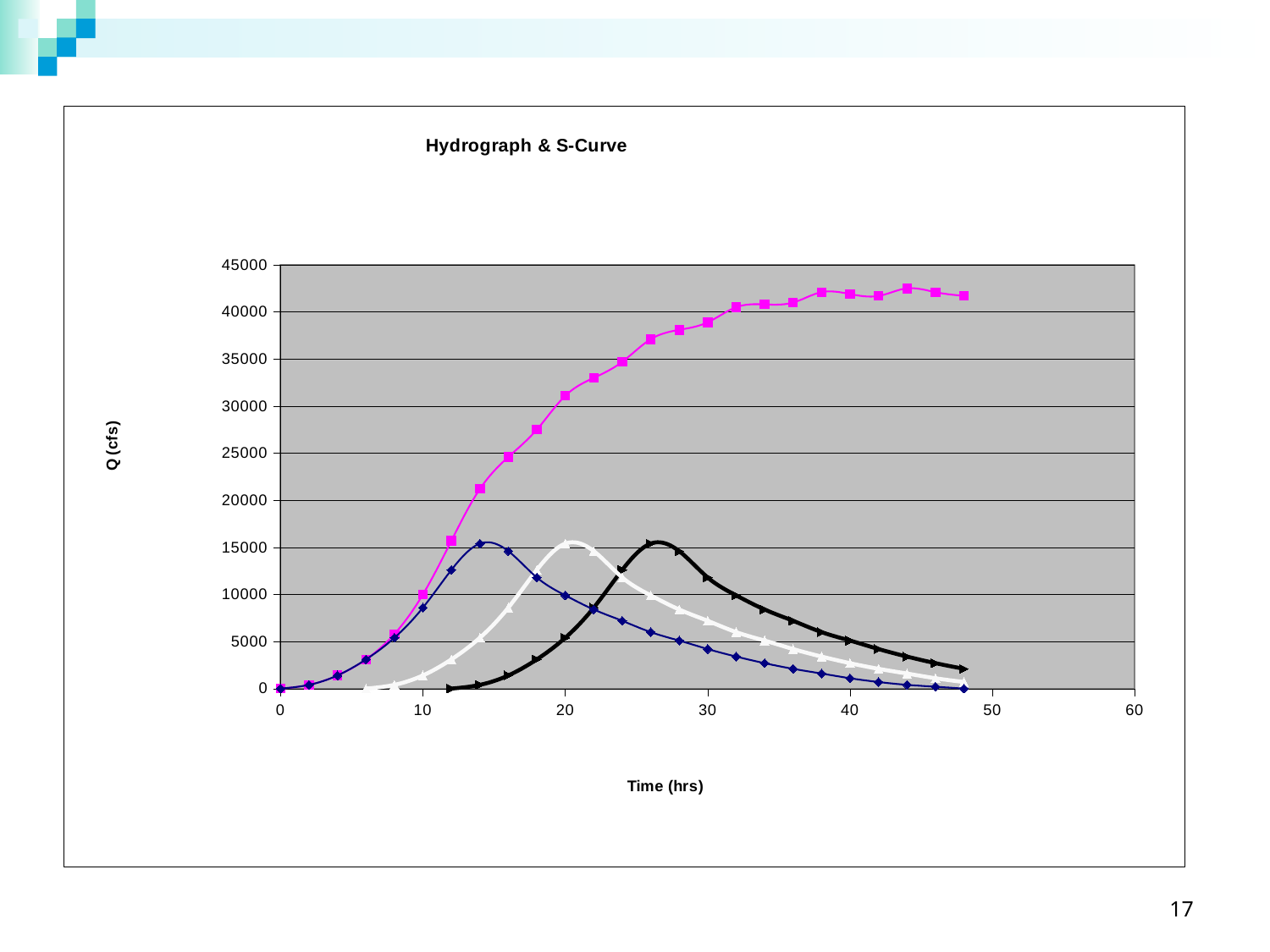
At 30 hrs, which is larger: the value of the black line or the value of the dark blue diamond-marker line? the black line What is the label of the vertical axis? Q (cfs) What kind of chart is shown on the slide? line chart What is the title of the chart? Hydrograph & S-Curve How many lines (series) are plotted on the chart? 4 Is the peak value of the dark blue diamond-marker line greater or less than 20000? less Is the value of the magenta square-marker line at 30 hrs greater or less than 40000? less Is the value of the black line at 30 hrs greater or less than 10000? greater Which series reaches the highest value on the chart? the magenta line with square markers Which of the three peaked hydrograph lines reaches its peak latest in time? the black line Does the magenta square-marker line rise or fall as time increases from 0 to 40 hrs? rise